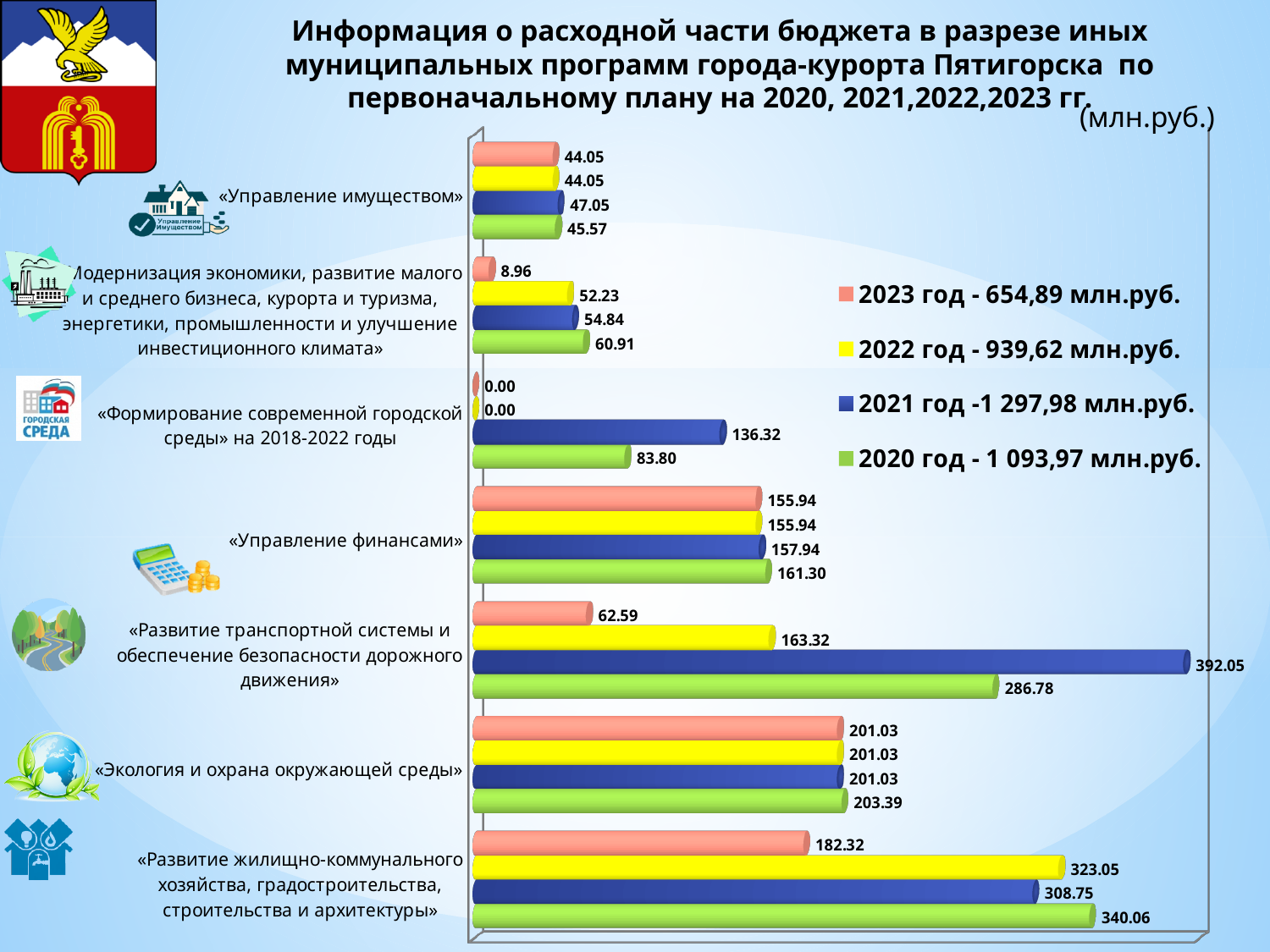
How many series does the legend list? 4 What is the difference between the 2022 год and 2023 год values for «Развитие жилищно-коммунального хозяйства, градостроительства, строительства и архитектуры»? 140.73 How many program categories are plotted on the chart? 7 What is the value for «Развитие транспортной системы и обеспечение безопасности дорожного движения» in the 2021 год series? 392.05 What is the value for «Управление имуществом» in the 2021 год series? 47.05 Which program has the highest value in the 2020 год series? «Развитие жилищно-коммунального хозяйства, градостроительства, строительства и архитектуры» What type of chart is shown on the slide? Bar chart Which program has the lowest value in the 2023 год series? «Формирование современной городской среды» на 2018-2022 годы What is the difference between the 2021 год and 2020 год values for «Развитие транспортной системы и обеспечение безопасности дорожного движения»? 105.27 According to the legend, what is the total for 2021 год? 1 297,98 млн.руб. Which is larger for «Модернизация экономики...»: the 2020 год value or the 2022 год value? 2020 год What is the value for «Формирование современной городской среды» на 2018-2022 годы in the 2023 год series? 0.00